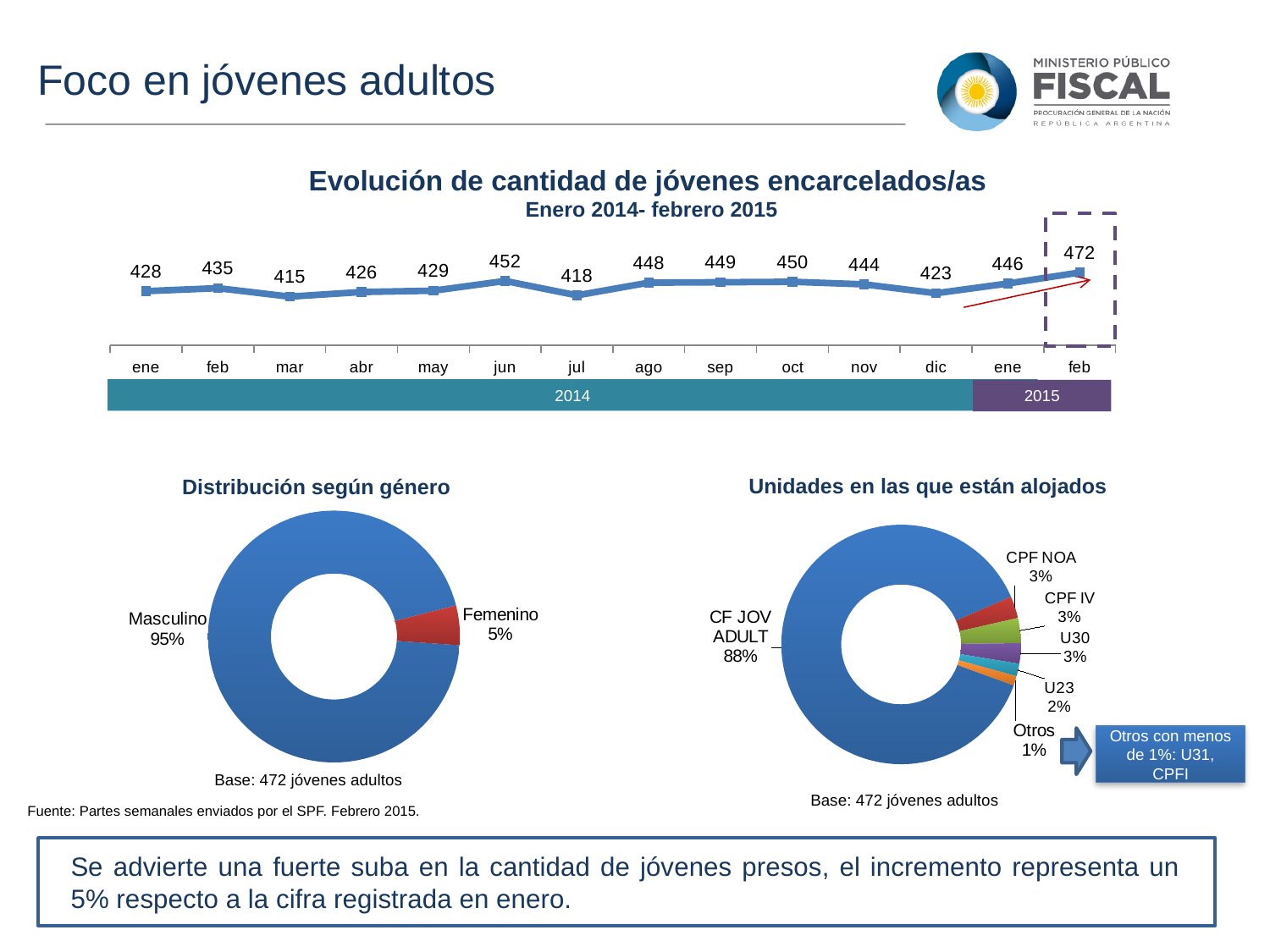
In the chart 'Distribución según género', what share is Femenino? 5% How many categories are shown in the chart 'Unidades en las que están alojados'? 6 In the chart 'Evolución de cantidad de jóvenes encarcelados/as', which is larger, the value for jul 2014 or the value for ago 2014? ago 2014 In the chart 'Evolución de cantidad de jóvenes encarcelados/as', what is the value for feb 2015? 472 How many data points are plotted in the chart 'Evolución de cantidad de jóvenes encarcelados/as'? 14 In the chart 'Evolución de cantidad de jóvenes encarcelados/as', which month has the highest value? feb 2015 What kind of chart is 'Evolución de cantidad de jóvenes encarcelados/as'? Line chart In the chart 'Unidades en las que están alojados', what is the value for CF JOV ADULT? 88% In the chart 'Evolución de cantidad de jóvenes encarcelados/as', which month has the lowest value? mar 2014 In the chart 'Distribución según género', what is the value for Masculino? 95% In the chart 'Evolución de cantidad de jóvenes encarcelados/as', what is the value for jun 2014? 452 In the chart 'Evolución de cantidad de jóvenes encarcelados/as', what is the difference between the values for feb 2015 and ene 2015? 26